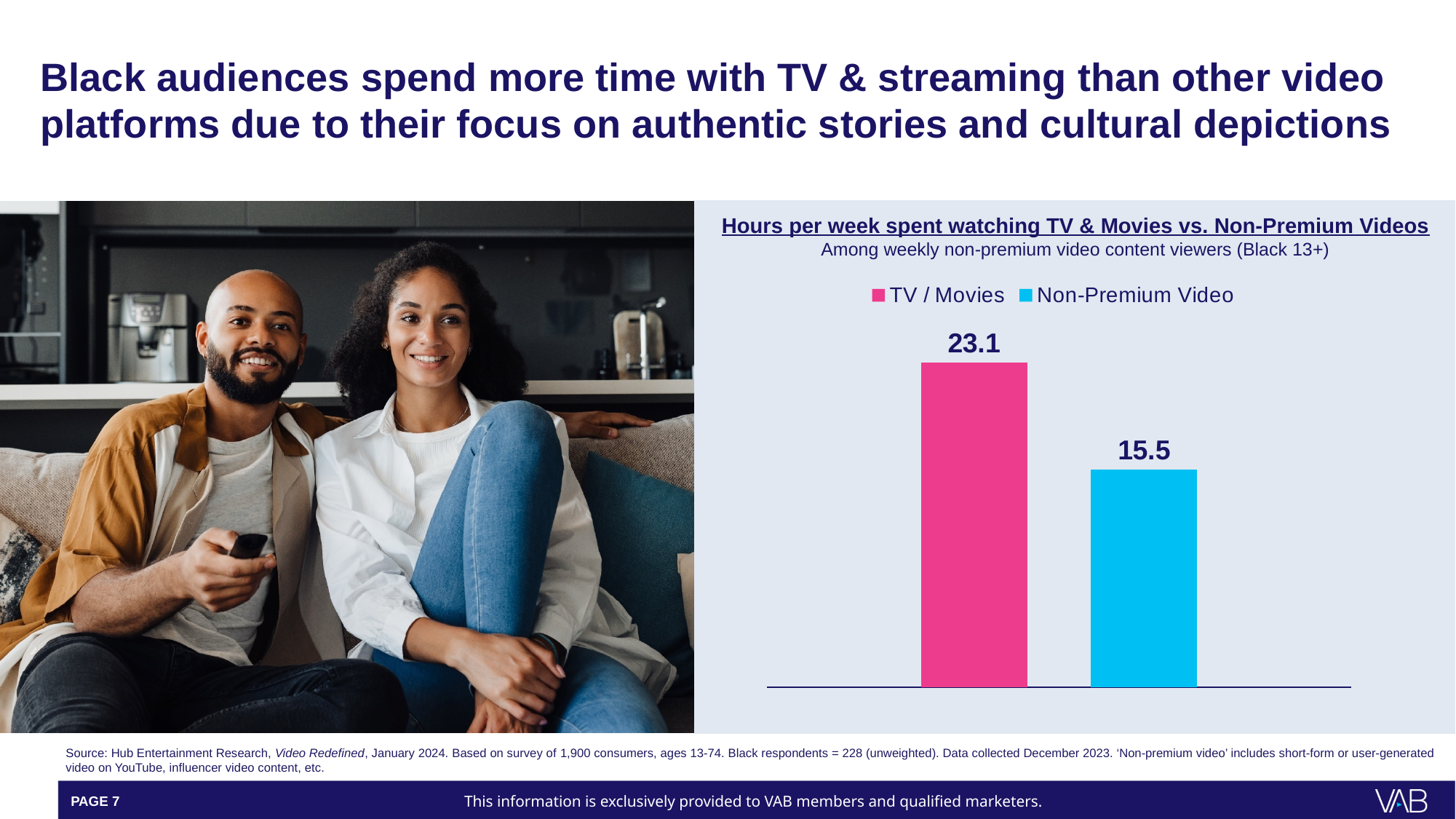
What is the difference between the TV / Movies value and the Non-Premium Video value? 7.6 How many entries does the legend list? 2 What is the title of the chart? Hours per week spent watching TV & Movies vs. Non-Premium Videos What is the value for Non-Premium Video? 15.5 How many bars are plotted in the chart? 2 Which is larger, the value for TV / Movies or the value for Non-Premium Video? TV / Movies What is the value for TV / Movies? 23.1 What kind of chart is shown on the slide? Bar chart Which category has the highest value? TV / Movies What colour is the Non-Premium Video bar? Blue Which category has the lowest value? Non-Premium Video